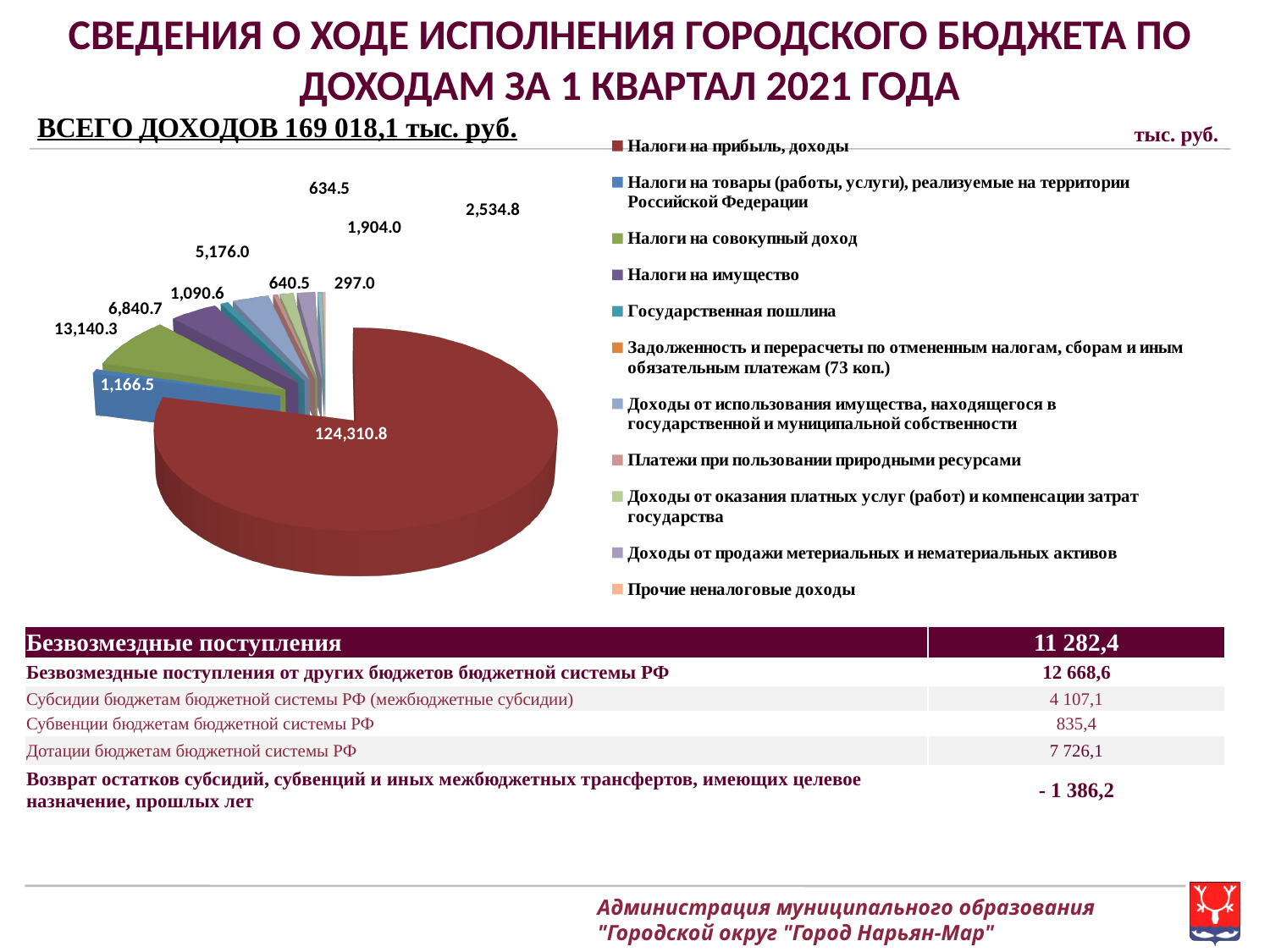
How many categories does the legend of the pie chart list? 11 Which category has the largest slice in the pie chart? Налоги на прибыль, доходы In what units are the values of the pie chart given, according to the label at the top right of the chart? тыс. руб. What total income is stated in the heading above the pie chart? 169 018,1 тыс. руб. What type of chart is shown on the slide? pie chart Is the value for Налоги на совокупный доход in the pie chart greater or less than 10,000? greater What is the difference between the values for Налоги на прибыль, доходы and Налоги на совокупный доход in the pie chart? 111,170.5 What is the value shown for Налоги на совокупный доход in the pie chart? 13,140.3 Which is larger in the pie chart: Налоги на прибыль, доходы or Налоги на совокупный доход? Налоги на прибыль, доходы What is the smallest data label shown on the pie chart? 297.0 What is the value shown for Налоги на товары (работы, услуги), реализуемые на территории Российской Федерации in the pie chart? 1,166.5 What is the value shown for Налоги на прибыль, доходы in the pie chart? 124,310.8